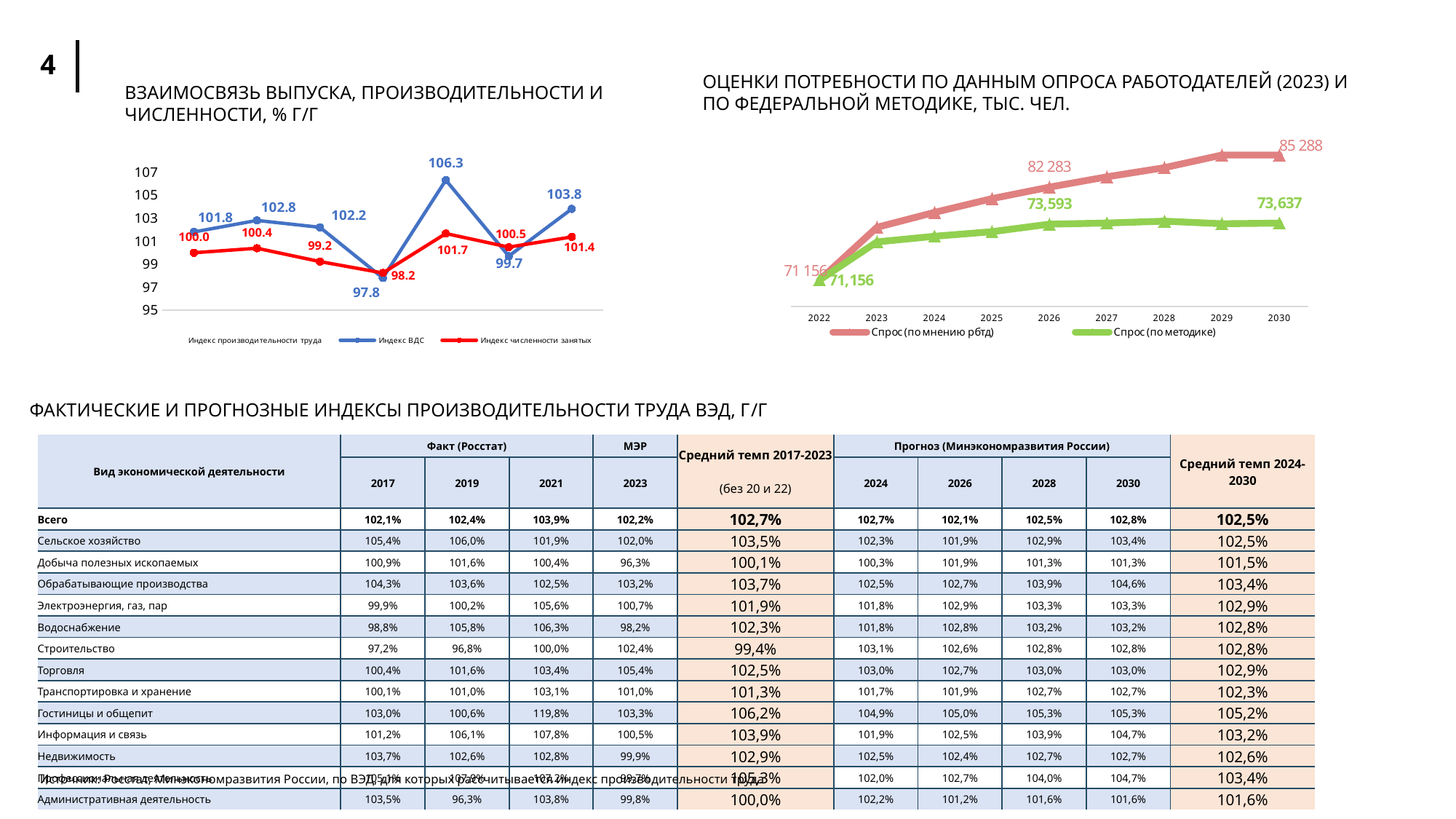
In the left chart 'ВЗАИМОСВЯЗЬ ВЫПУСКА, ПРОИЗВОДИТЕЛЬНОСТИ И ЧИСЛЕННОСТИ, % Г/Г', how many entries does the legend list? 3 In the left chart 'ВЗАИМОСВЯЗЬ ВЫПУСКА, ПРОИЗВОДИТЕЛЬНОСТИ И ЧИСЛЕННОСТИ, % Г/Г', what is the highest value labelled on the red 'Индекс численности занятых' line? 101.7 In the left chart 'ВЗАИМОСВЯЗЬ ВЫПУСКА, ПРОИЗВОДИТЕЛЬНОСТИ И ЧИСЛЕННОСТИ, % Г/Г', what is the lowest value labelled on the blue 'Индекс ВДС' line? 97.8 In the right chart 'ОЦЕНКИ ПОТРЕБНОСТИ ПО ДАННЫМ ОПРОСА РАБОТОДАТЕЛЕЙ (2023) И ПО ФЕДЕРАЛЬНОЙ МЕТОДИКЕ, ТЫС. ЧЕЛ.', how many years are shown on the x axis? 9 In the left chart 'ВЗАИМОСВЯЗЬ ВЫПУСКА, ПРОИЗВОДИТЕЛЬНОСТИ И ЧИСЛЕННОСТИ, % Г/Г', what is the lowest value labelled on the red 'Индекс численности занятых' line? 98.2 In the right chart 'ОЦЕНКИ ПОТРЕБНОСТИ ПО ДАННЫМ ОПРОСА РАБОТОДАТЕЛЕЙ (2023) И ПО ФЕДЕРАЛЬНОЙ МЕТОДИКЕ, ТЫС. ЧЕЛ.', does the 'Спрос (по мнению рбтд)' line rise or fall from 2022 to 2030? rise In the right chart 'ОЦЕНКИ ПОТРЕБНОСТИ ПО ДАННЫМ ОПРОСА РАБОТОДАТЕЛЕЙ (2023) И ПО ФЕДЕРАЛЬНОЙ МЕТОДИКЕ, ТЫС. ЧЕЛ.', which series has the larger value in 2030? Спрос (по мнению рбтд) In the right chart 'ОЦЕНКИ ПОТРЕБНОСТИ ПО ДАННЫМ ОПРОСА РАБОТОДАТЕЛЕЙ (2023) И ПО ФЕДЕРАЛЬНОЙ МЕТОДИКЕ, ТЫС. ЧЕЛ.', what is the difference between the two series' values in 2030? 11 651 In the left chart 'ВЗАИМОСВЯЗЬ ВЫПУСКА, ПРОИЗВОДИТЕЛЬНОСТИ И ЧИСЛЕННОСТИ, % Г/Г', what is the highest value labelled on the blue 'Индекс ВДС' line? 106.3 In the right chart 'ОЦЕНКИ ПОТРЕБНОСТИ ПО ДАННЫМ ОПРОСА РАБОТОДАТЕЛЕЙ (2023) И ПО ФЕДЕРАЛЬНОЙ МЕТОДИКЕ, ТЫС. ЧЕЛ.', what is the value of 'Спрос (по мнению рбтд)' in 2030? 85 288 In the right chart 'ОЦЕНКИ ПОТРЕБНОСТИ ПО ДАННЫМ ОПРОСА РАБОТОДАТЕЛЕЙ (2023) И ПО ФЕДЕРАЛЬНОЙ МЕТОДИКЕ, ТЫС. ЧЕЛ.', what is the value of 'Спрос (по методике)' in 2030? 73,637 In the left chart 'ВЗАИМОСВЯЗЬ ВЫПУСКА, ПРОИЗВОДИТЕЛЬНОСТИ И ЧИСЛЕННОСТИ, % Г/Г', how many data points does the blue 'Индекс ВДС' line have? 7